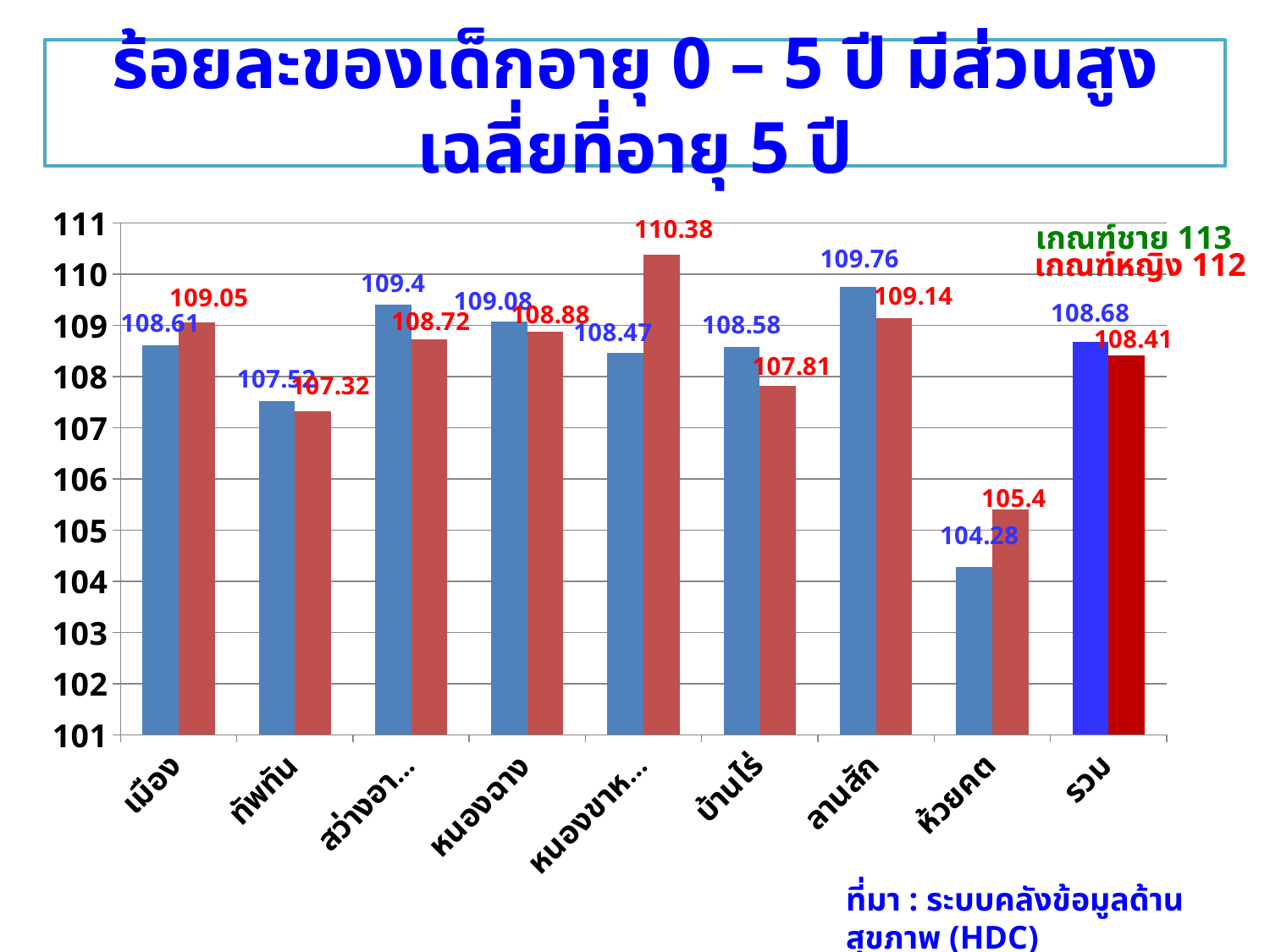
For ห้วยคต, which is larger, the blue bar or the red bar? the red bar What kind of chart is shown on the slide? bar chart How many categories are shown along the x axis of the chart? 9 What is the value of the red bar for บ้านไร่? 107.81 What is the difference between the red bar and the blue bar for เมือง? 0.44 What is the value of the blue bar for ลานสัก? 109.76 What is the value of the blue bar for รวม? 108.68 Which category has the highest blue bar? ลานสัก What value is given for เกณฑ์ชาย in the text on the chart? 113 Which category has the lowest blue bar? ห้วยคต What is the value of the red bar for หนองขาห...? 110.38 Is the value of the blue bar for ห้วยคต greater or less than 105? less